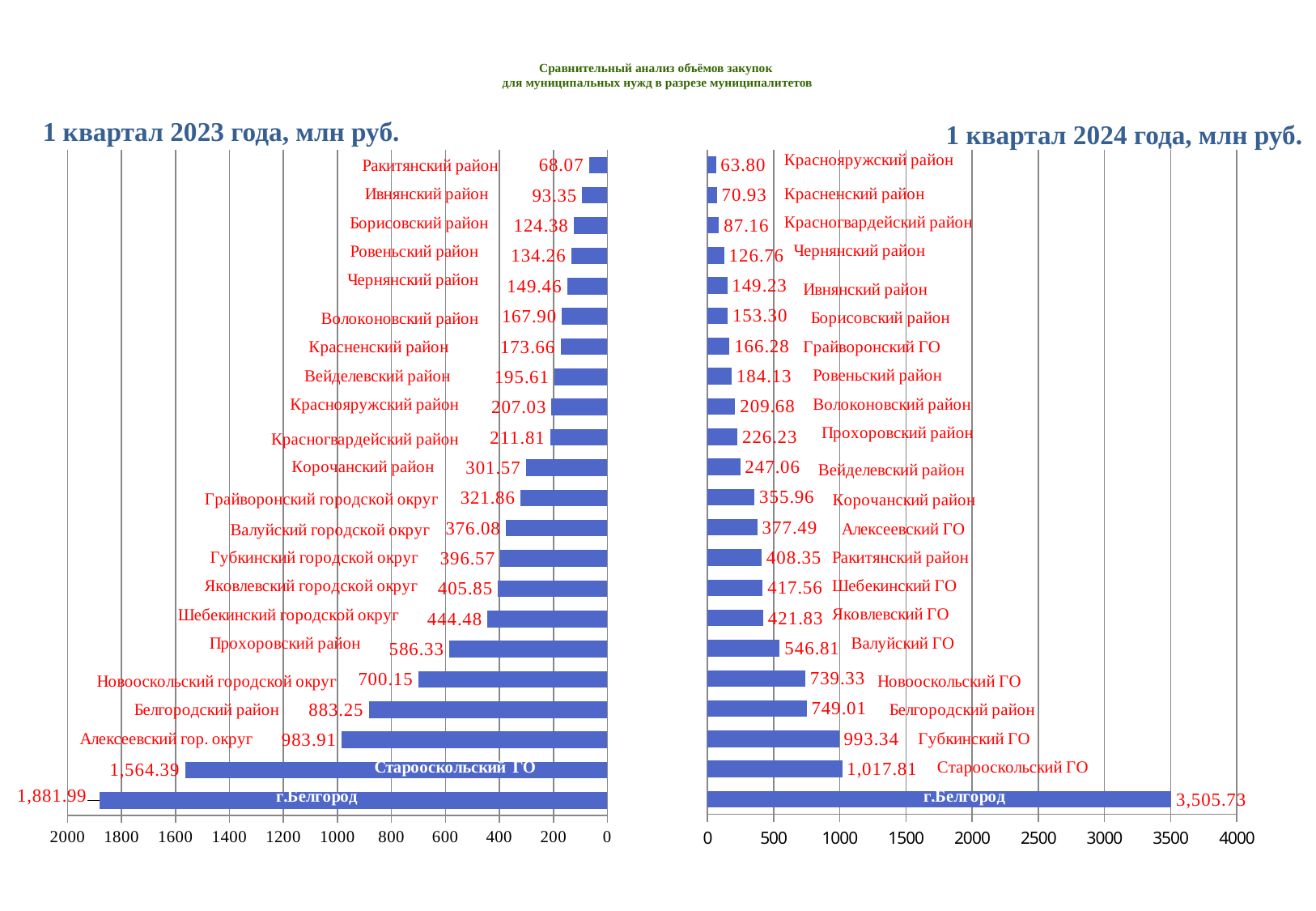
What is the difference between the value for г.Белгород on the "1 квартал 2024 года" chart and on the "1 квартал 2023 года" chart? 1,623.74 On the chart titled "1 квартал 2023 года, млн руб.", which category has the highest value? г.Белгород What type of chart is the one titled "1 квартал 2023 года, млн руб."? bar chart What is the maximum value shown on the x axis of the chart titled "1 квартал 2024 года, млн руб."? 4000 On the chart titled "1 квартал 2024 года, млн руб.", what is the value for Губкинский ГО? 993.34 On the chart titled "1 квартал 2023 года, млн руб.", what is the value for Прохоровский район? 586.33 On the chart titled "1 квартал 2024 года, млн руб.", which category has the lowest value? Краснояружский район On the chart titled "1 квартал 2023 года, млн руб.", which category has the lowest value? Ракитянский район On the chart titled "1 квартал 2023 года, млн руб.", what is the difference between Старооскольский ГО and Алексеевский гор. округ? 580.48 On the chart titled "1 квартал 2024 года, млн руб.", which is larger: Валуйский ГО or Новооскольский ГО? Новооскольский ГО How many categories are shown on the chart titled "1 квартал 2024 года, млн руб."? 22 Is the value for Белгородский район larger on the "1 квартал 2023 года" chart or on the "1 квартал 2024 года" chart? 1 квартал 2023 года